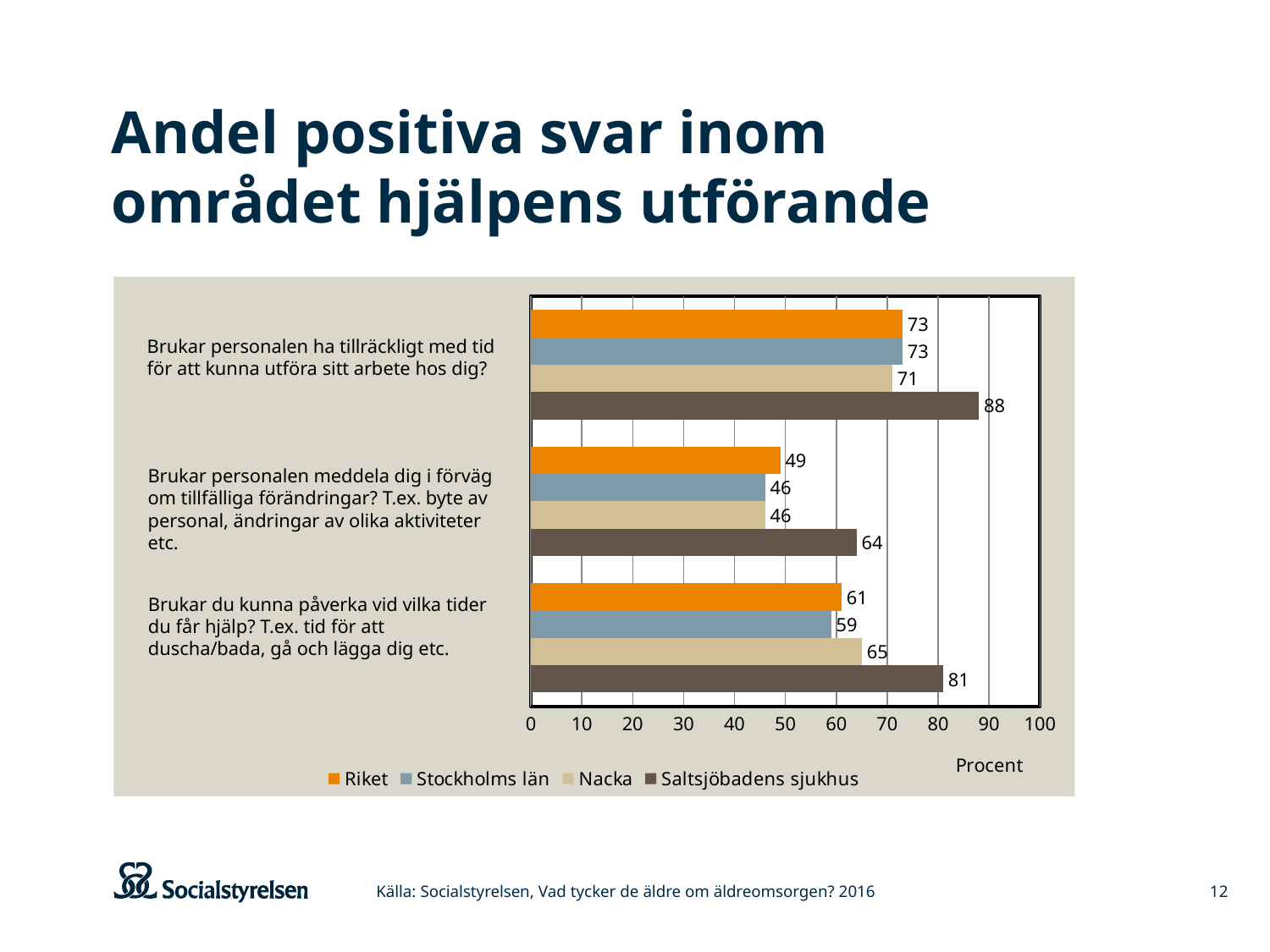
Is the value for Stockholms län for the question "Brukar personalen meddela dig i förväg om tillfälliga förändringar?" greater or less than 50? less What is the value for Riket for the question "Brukar personalen meddela dig i förväg om tillfälliga förändringar?"? 49 What unit label is shown on the x axis of the chart? Procent How many question categories are plotted on the chart? 3 For the question "Brukar du kunna påverka vid vilka tider du får hjälp?", which is larger: Nacka or Riket? Nacka What is the value for Nacka for the question "Brukar du kunna påverka vid vilka tider du får hjälp?"? 65 Which series has the lowest value for the question "Brukar du kunna påverka vid vilka tider du får hjälp?"? Stockholms län What is the difference between Saltsjöbadens sjukhus and Riket for the question "Brukar personalen ha tillräckligt med tid för att kunna utföra sitt arbete hos dig?"? 15 What is the value for Saltsjöbadens sjukhus for the question "Brukar personalen ha tillräckligt med tid för att kunna utföra sitt arbete hos dig?"? 88 Which series has the highest value for the question "Brukar personalen meddela dig i förväg om tillfälliga förändringar?"? Saltsjöbadens sjukhus What kind of chart is shown on the slide? Bar chart How many series does the legend list? 4